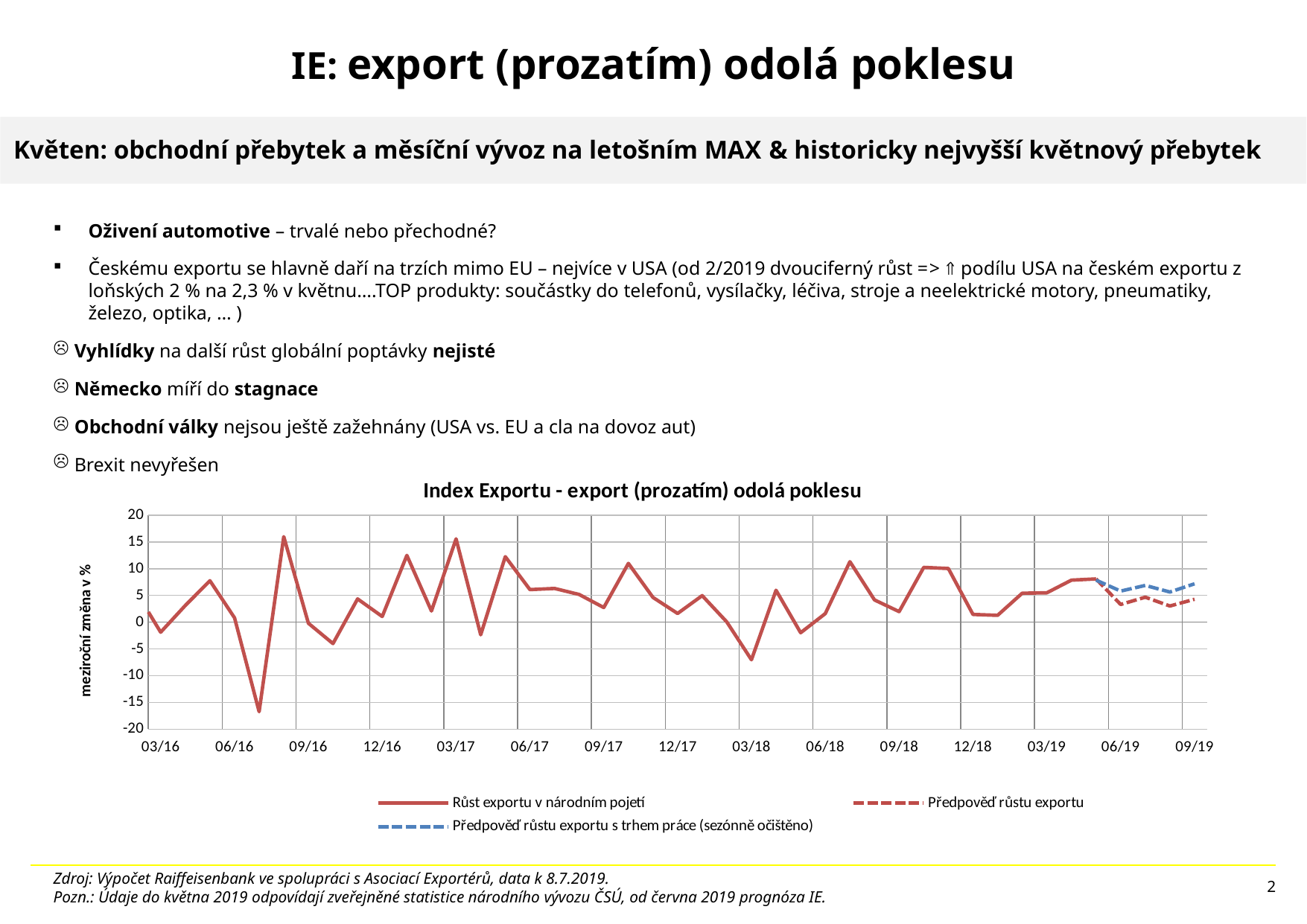
Which is larger: the value of 'Růst exportu v národním pojetí' at 03/17 or at 03/18? 03/17 In which year does the lowest value of the 'Růst exportu v národním pojetí' line occur? 2016 Is the value of 'Růst exportu v národním pojetí' at 12/18 greater or less than 5? less How many labels are shown on the x axis of the chart? 15 What kind of chart is shown on the slide? line chart How many series does the chart legend list? 3 What is the title of the chart? Index Exportu - export (prozatím) odolá poklesu What is the label of the vertical axis of the chart? meziroční změna v % Is the value of 'Růst exportu v národním pojetí' at 03/18 greater or less than -5? less At 09/19, which forecast line is higher: 'Předpověď růstu exportu' or 'Předpověď růstu exportu s trhem práce (sezónně očištěno)'? Předpověď růstu exportu s trhem práce (sezónně očištěno) Is the value of 'Růst exportu v národním pojetí' at 03/17 greater or less than 10? greater